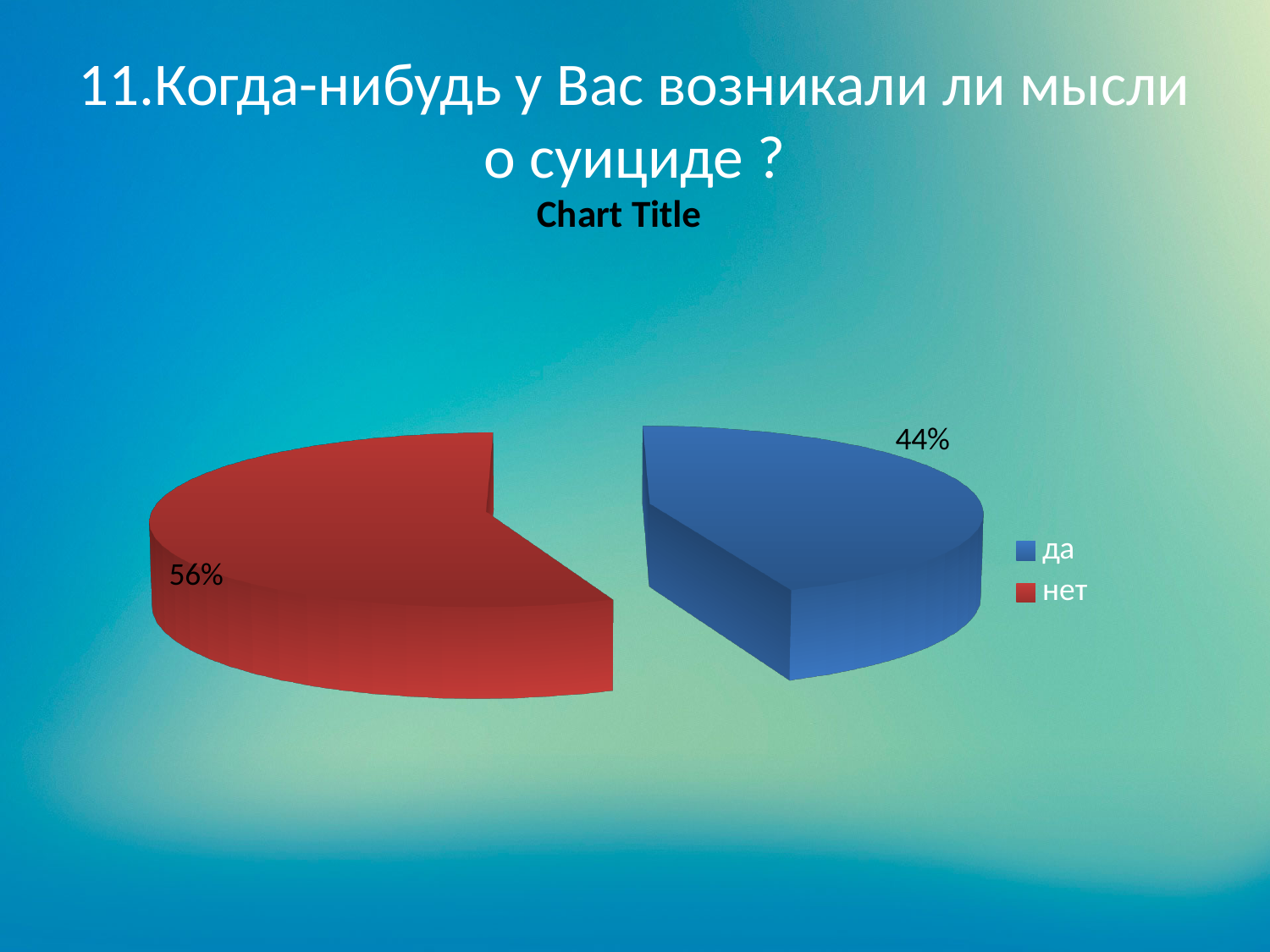
What kind of chart is shown on the slide? pie chart What colour is the "нет" slice? red How many slices does the pie chart have? 2 Which slice is the smallest? да What percentage is shown for the "да" slice? 44% What share of the pie does the "да" slice represent? 44% What is the title printed directly above the pie chart? Chart Title What percentage is shown for the "нет" slice? 56% What is the difference between the "нет" and "да" slices? 12% Which is larger, the "да" slice or the "нет" slice? нет Which slice is the largest? нет How many entries does the legend list? 2